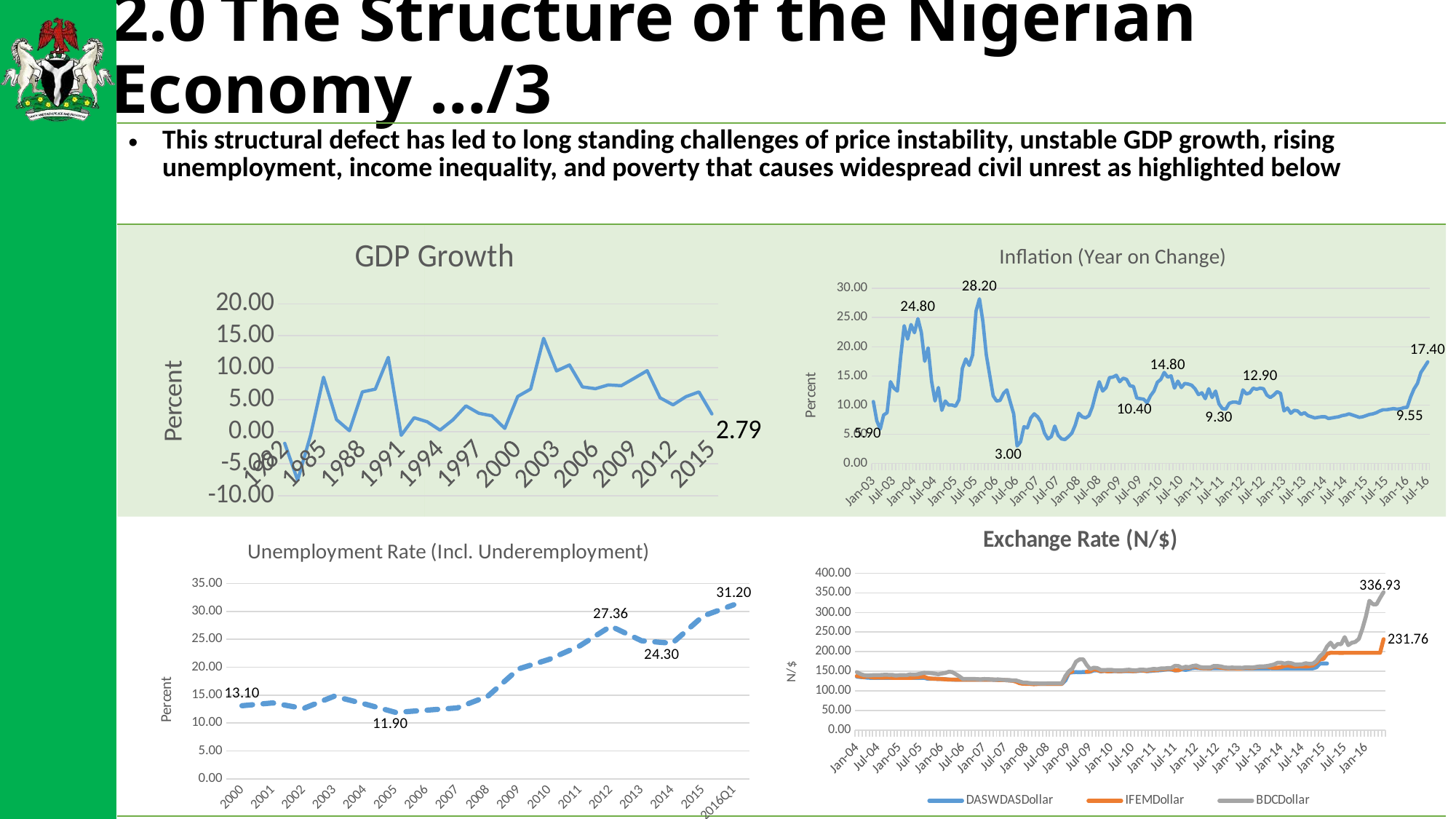
In the Inflation (Year on Change) chart, what is the highest labelled value? 28.20 How many series does the legend of the Exchange Rate (N/$) chart list? 3 In the Unemployment Rate (Incl. Underemployment) chart, what is the value labelled for 2012? 27.36 In the Unemployment Rate (Incl. Underemployment) chart, what is the value for 2016Q1? 31.20 In the Inflation (Year on Change) chart, what is the last labelled value at the right end of the line? 17.40 In the GDP Growth chart, what is the value labelled at the end of the line? 2.79 In the Unemployment Rate (Incl. Underemployment) chart, which year has the higher value, 2012 or 2013? 2012 In the Exchange Rate (N/$) chart, what is the final labelled value of the BDCDollar series? 336.93 What kind of chart is the GDP Growth chart? Line chart In the Inflation (Year on Change) chart, what is the lowest labelled value? 3.00 In the Exchange Rate (N/$) chart, what is the difference between the final labelled BDCDollar value and the final labelled IFEMDollar value? 105.17